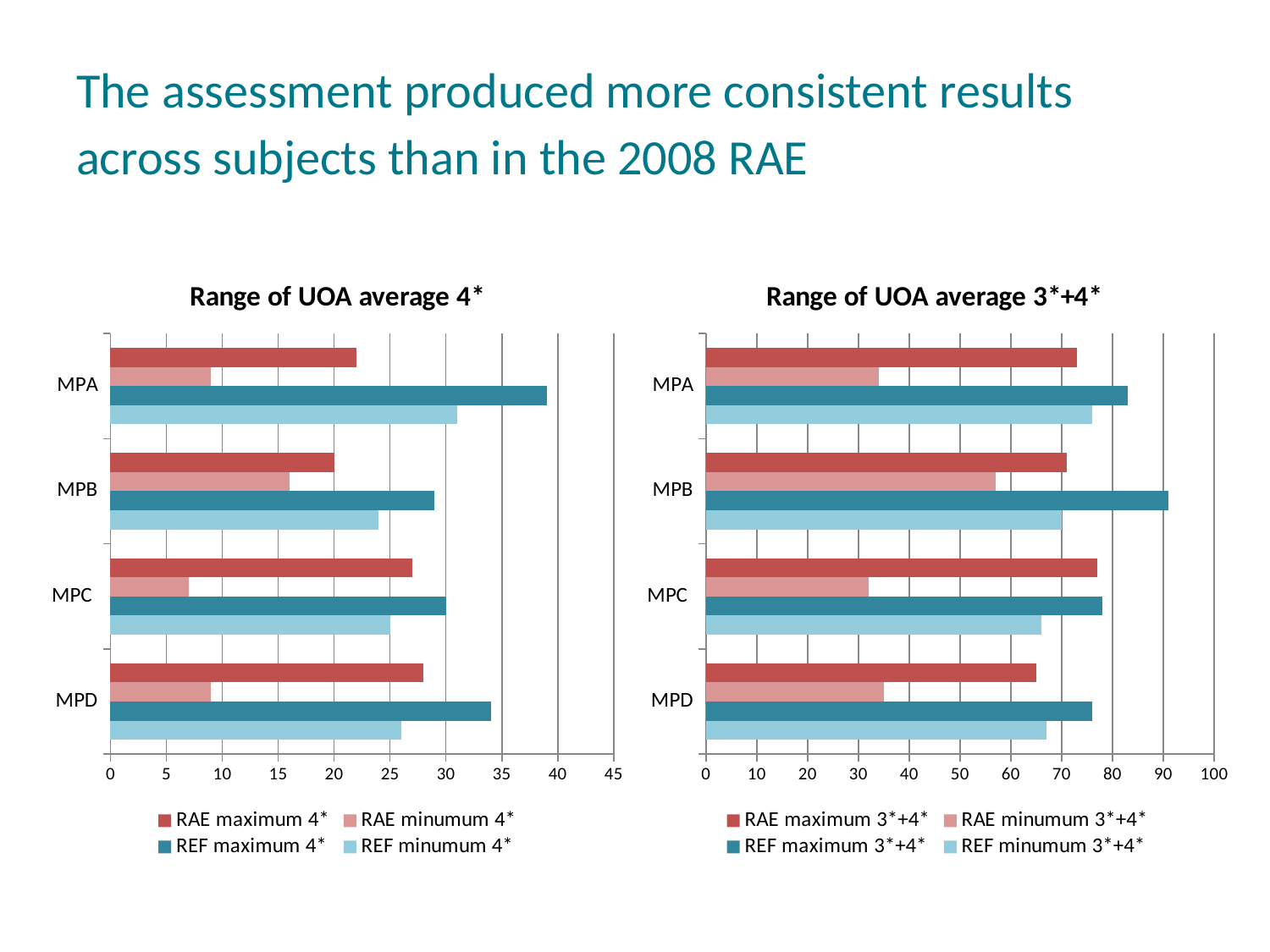
How many categories are shown on the left chart, 'Range of UOA average 4*'? 4 In the left chart, 'Range of UOA average 4*', is the RAE minumum 4* value for MPC greater or less than 10? less In the right chart, 'Range of UOA average 3*+4*', which is larger for MPB: the REF maximum 3*+4* value or the RAE maximum 3*+4* value? REF maximum 3*+4* In the right chart, 'Range of UOA average 3*+4*', is the REF minumum 3*+4* value for MPC greater or less than 70? less In the right chart, 'Range of UOA average 3*+4*', which category has the highest RAE minumum 3*+4* value? MPB What is the title of the right chart? Range of UOA average 3*+4* In the right chart, 'Range of UOA average 3*+4*', which category has the highest REF maximum 3*+4* value? MPB In the right chart, 'Range of UOA average 3*+4*', is the RAE minumum 3*+4* value for MPB greater or less than 50? greater What kind of chart is the left chart, 'Range of UOA average 4*'? bar chart In the left chart, 'Range of UOA average 4*', which category has the highest REF maximum 4* value? MPA How many series does the legend of the right chart, 'Range of UOA average 3*+4*', list? 4